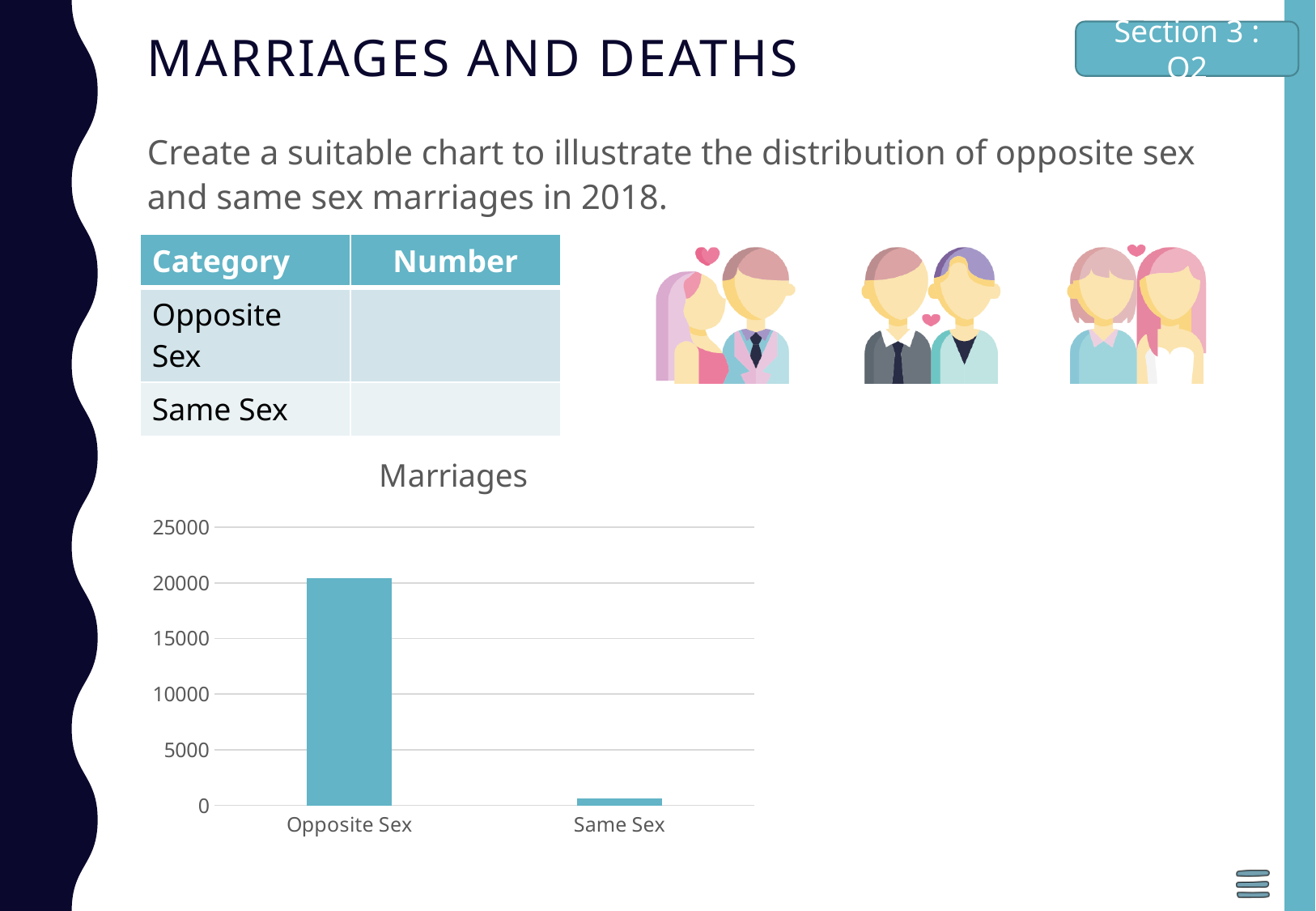
Is the value for Same Sex greater or less than 5000? less Which category has the highest value in the chart? Opposite Sex How many categories are plotted on the chart? 2 Is the value for Opposite Sex greater or less than 25000? less Do the values rise or fall from Opposite Sex to Same Sex along the x axis? fall What is the title of the chart? Marriages What is the highest value shown on the chart's vertical axis? 25000 What kind of chart is shown on the slide? bar chart Which is larger, the value for Opposite Sex or the value for Same Sex? Opposite Sex Which category has the lowest value in the chart? Same Sex